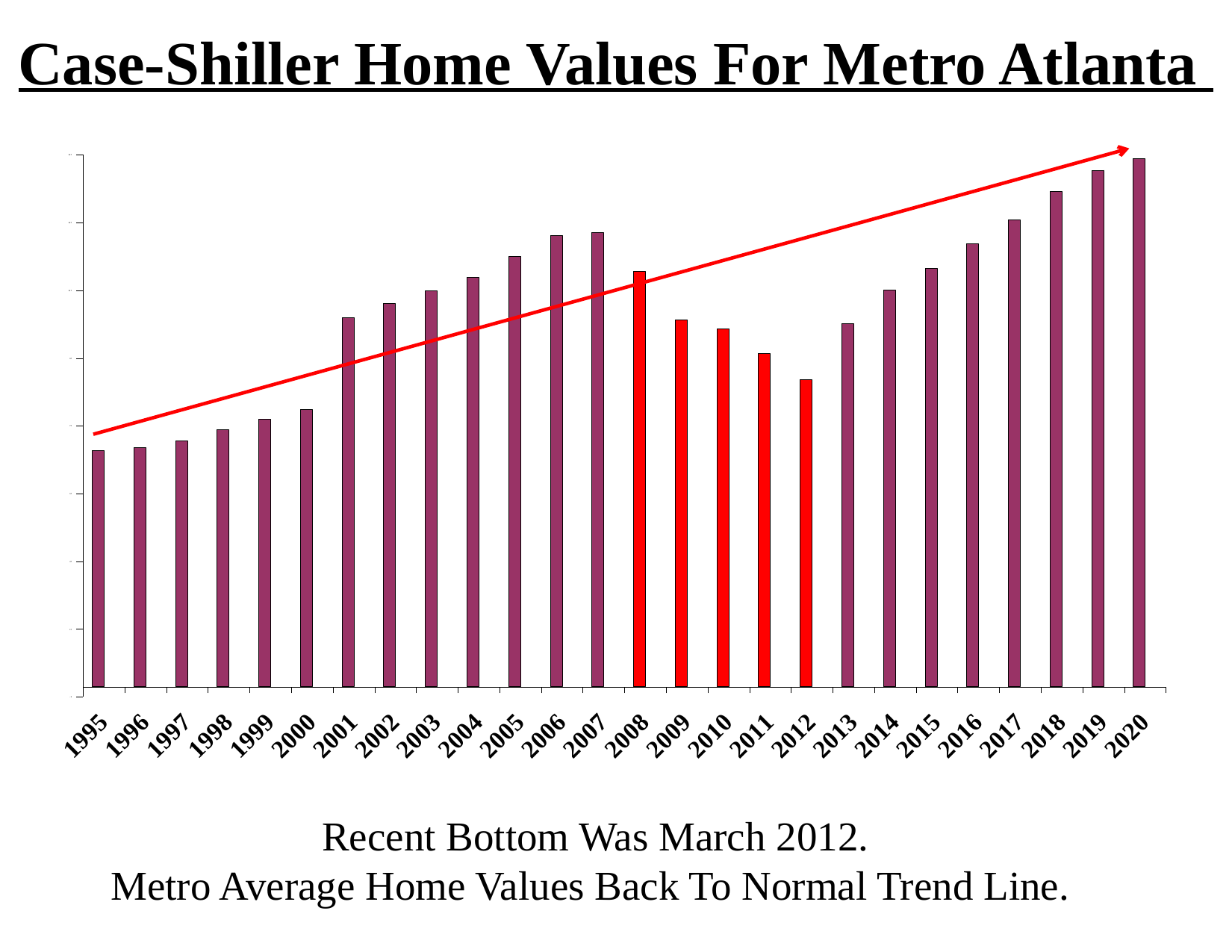
Which year has the highest home value in the chart? 2020 Do the values rise or fall from 2008 to 2012? Fall What kind of chart is shown on the slide? Bar chart Which years are shown with bright red bars in the chart? 2008, 2009, 2010, 2011, 2012 Do the values rise or fall from 1995 to 2007? Rise Which year has the higher value, 2019 or 2020? 2020 Which year has the higher value, 2000 or 2001? 2001 Do the values rise or fall from 2012 to 2020? Rise What is the title of the chart on the slide? Case-Shiller Home Values For Metro Atlanta Which year has the higher value, 2007 or 2012? 2007 How many years are plotted on the x axis of the chart? 26